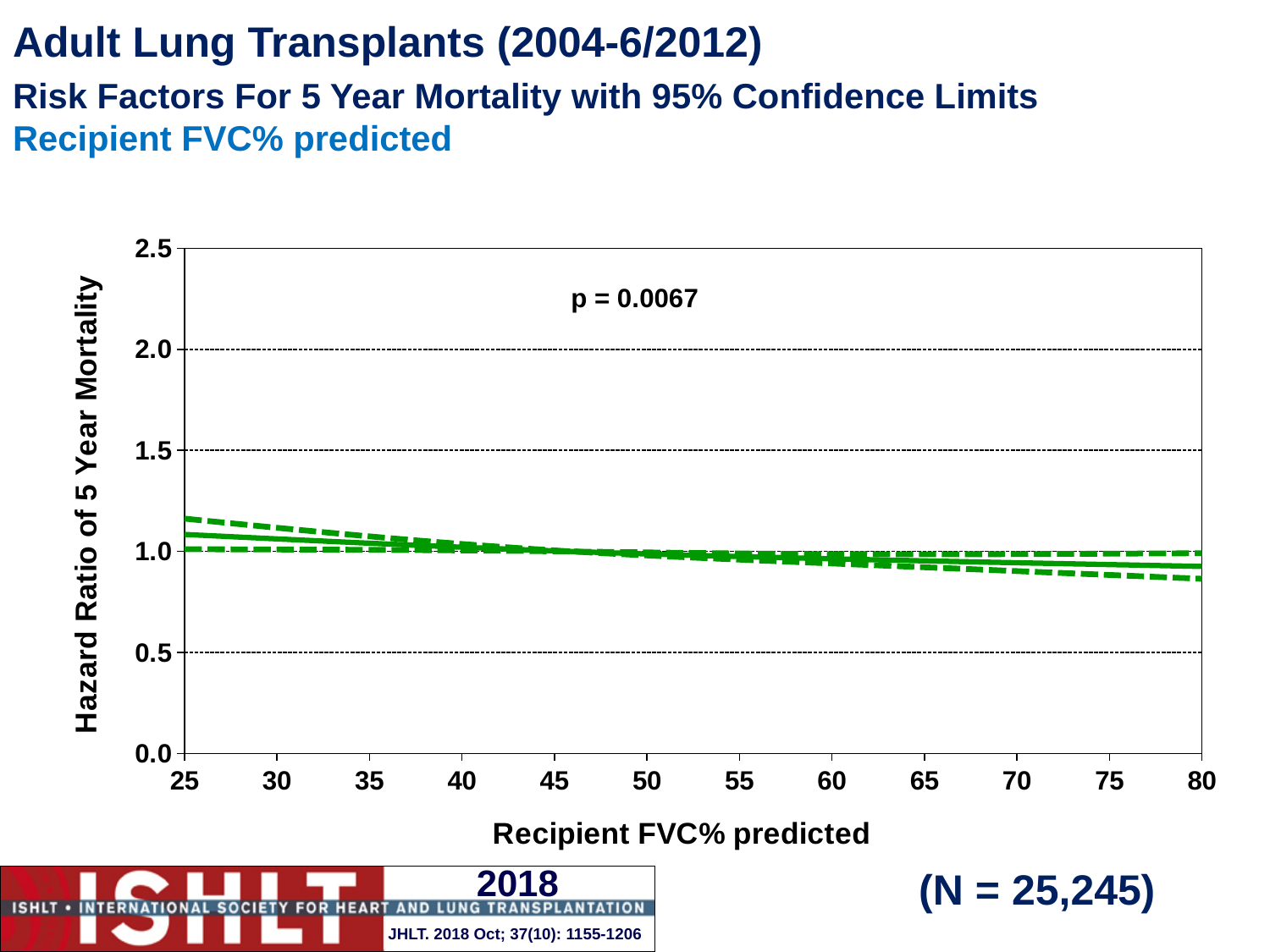
Does the hazard ratio of 5 year mortality rise or fall as Recipient FVC% predicted increases from 25 to 80? fall Is the hazard ratio at a Recipient FVC% predicted of 50 greater or less than 1.5? less Which has the larger hazard ratio: a Recipient FVC% predicted of 25 or of 80? 25 What is the label of the y axis? Hazard Ratio of 5 Year Mortality Is the hazard ratio at a Recipient FVC% predicted of 25 greater or less than 1.0? greater What kind of chart is shown on the slide? line chart Is the hazard ratio at a Recipient FVC% predicted of 80 greater or less than 1.0? less What p-value is printed on the chart? p = 0.0067 At which end of the x axis, 25 or 80, is the hazard ratio of 5 year mortality highest? 25 What is the label of the x axis? Recipient FVC% predicted How many lines (the estimate plus its confidence limits) are plotted on the chart? 3 What sample size (N) is printed on the slide? N = 25,245